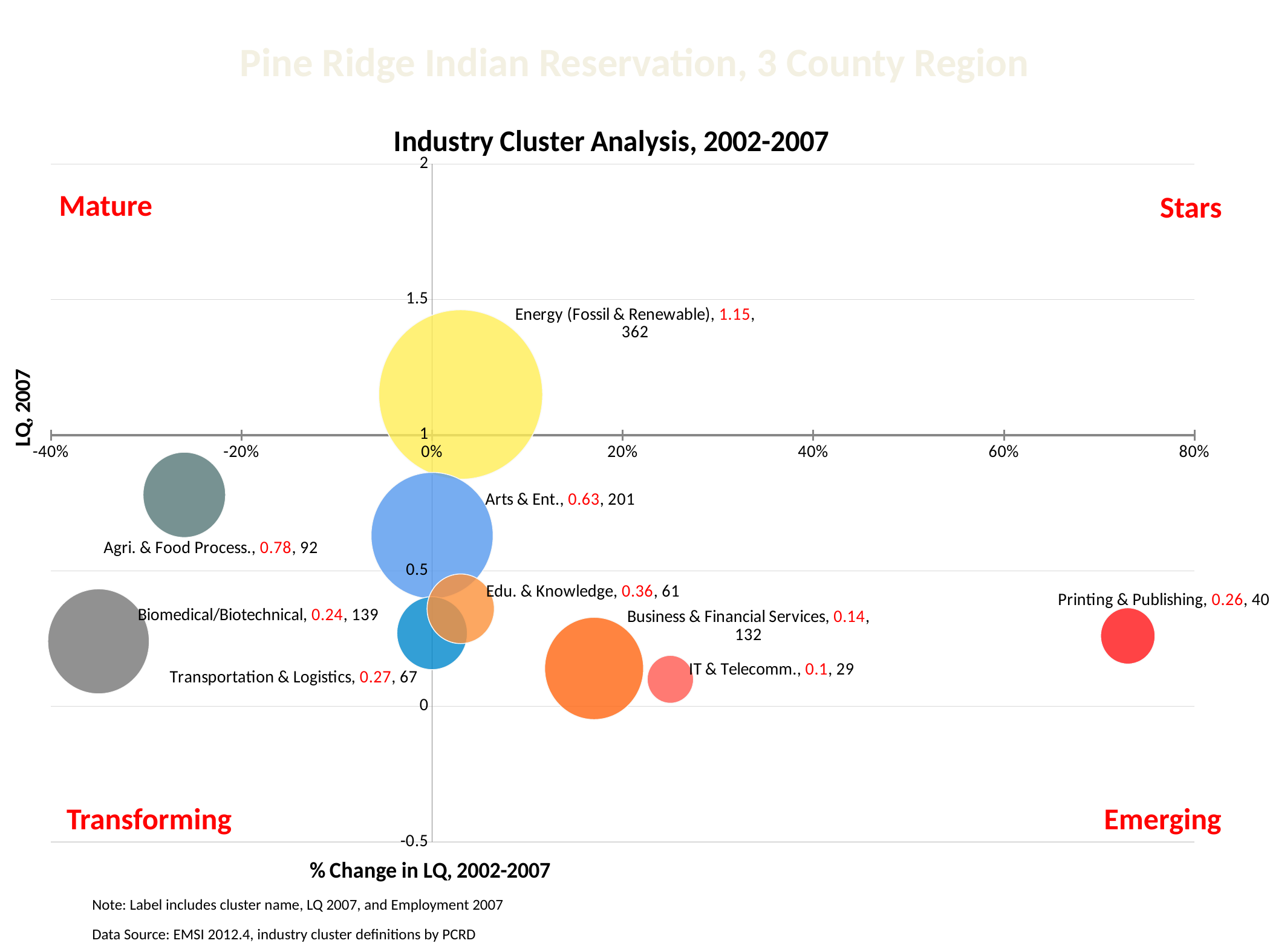
Is the % Change in LQ for Biomedical/Biotechnical greater or less than -20%? less What is the difference in Employment 2007 between Energy (Fossil & Renewable) and Arts & Ent.? 161 What is the LQ 2007 value shown for Energy (Fossil & Renewable)? 1.15 Which cluster has the highest LQ 2007 value? Energy (Fossil & Renewable) What is the LQ 2007 value shown for Agri. & Food Process.? 0.78 Which has a higher LQ 2007, Biomedical/Biotechnical or Transportation & Logistics? Transportation & Logistics What type of chart is shown on the slide? Bubble chart Is the % Change in LQ for Printing & Publishing greater or less than 60%? greater Which cluster has the smallest Employment 2007 figure? IT & Telecomm. Which cluster has the lowest LQ 2007 value? IT & Telecomm. How many industry clusters are plotted on the chart? 9 What is the Employment 2007 figure shown for Arts & Ent.? 201